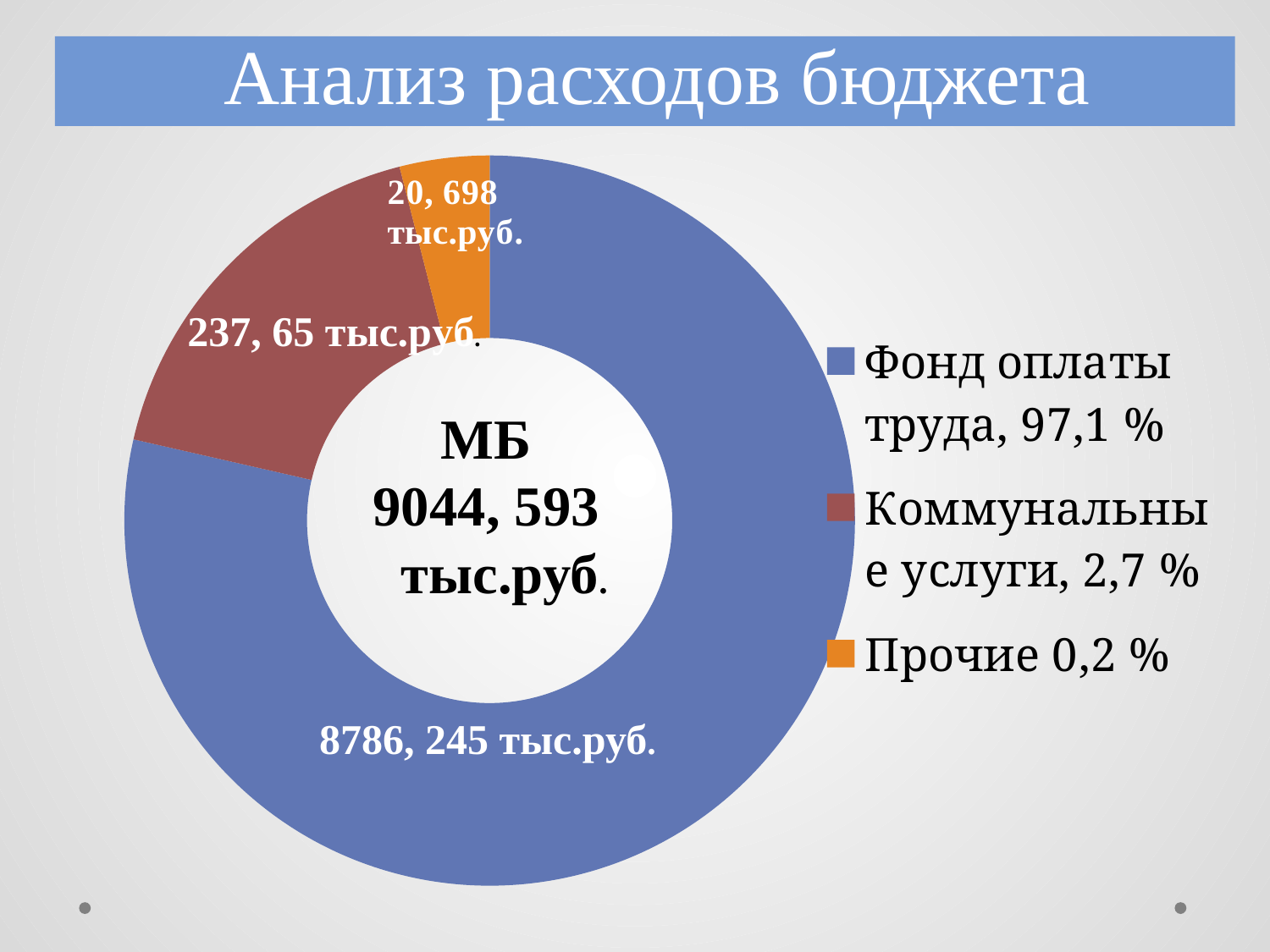
What total is shown in the centre of the doughnut chart? МБ 9044, 593 тыс.руб. What value is labelled on the slice for Коммунальные услуги? 237, 65 тыс.руб. According to the legend, what share of the budget expenses is Коммунальные услуги? 2,7 % What is the title of the slide with the chart? Анализ расходов бюджета Which category has the smallest slice of the chart? Прочие Which colour represents Прочие in the chart? Orange How many categories does the chart's legend list? 3 What value is labelled on the slice for Фонд оплаты труда? 8786, 245 тыс.руб. What value is labelled on the slice for Прочие? 20, 698 тыс.руб. Which category has the largest slice of the chart? Фонд оплаты труда What kind of chart is shown on the slide? Doughnut (pie) chart According to the legend, what share of the budget expenses is Фонд оплаты труда? 97,1 %